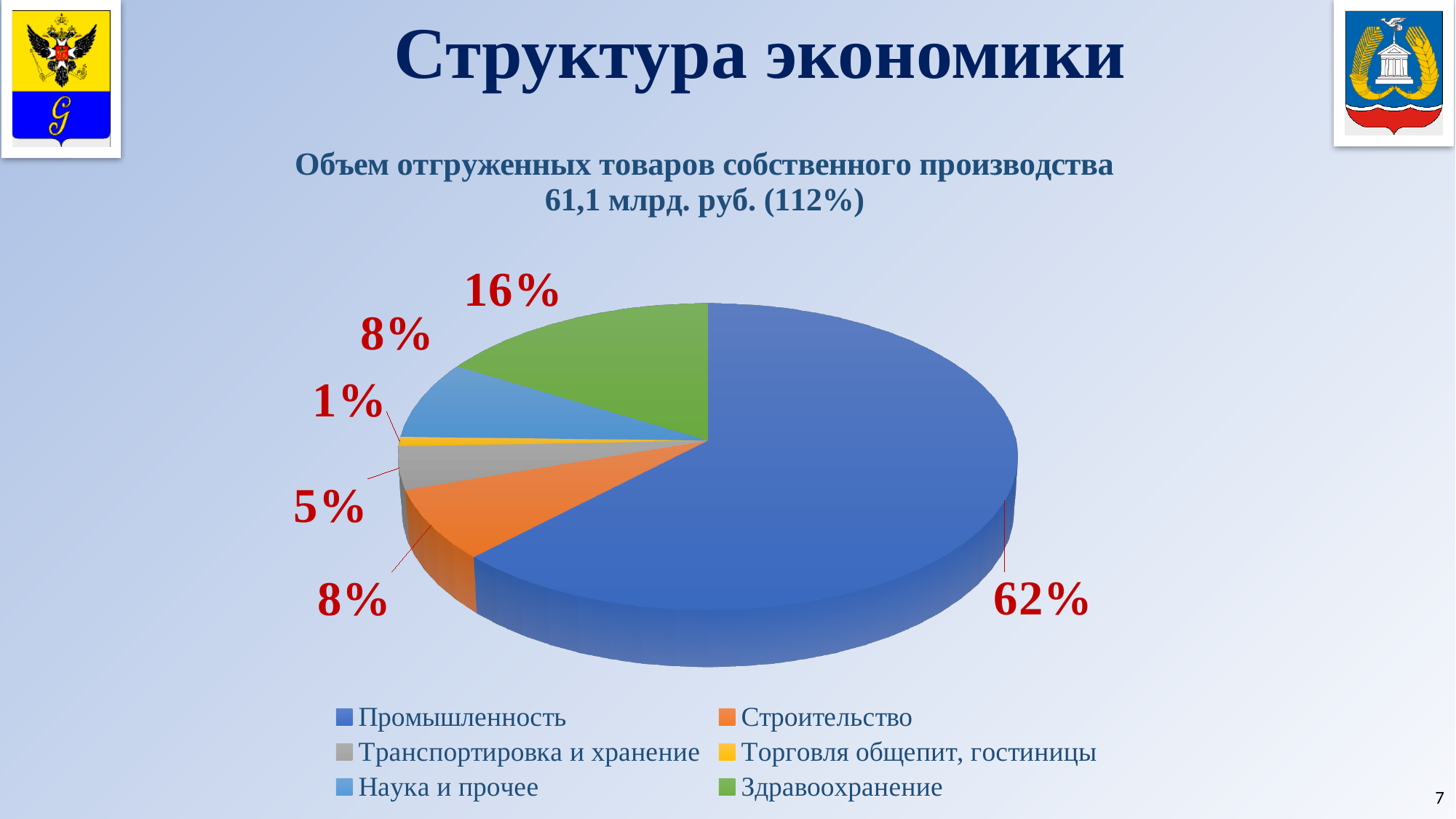
Which category has the smallest share of the pie? Торговля общепит, гостиницы What is the value for Здравоохранение? 16% What colour is the slice for Здравоохранение? green How many categories does the pie chart have? 6 What is the value for Строительство? 8% What share of the pie does Промышленность have? 62% Which category has the largest share of the pie? Промышленность What is the value for Торговля общепит, гостиницы? 1% What is the value for Транспортировка и хранение? 5% What is the difference between the shares of Промышленность and Здравоохранение? 46% What kind of chart is shown on the slide? pie chart Which is larger, the share of Здравоохранение or the share of Наука и прочее? Здравоохранение